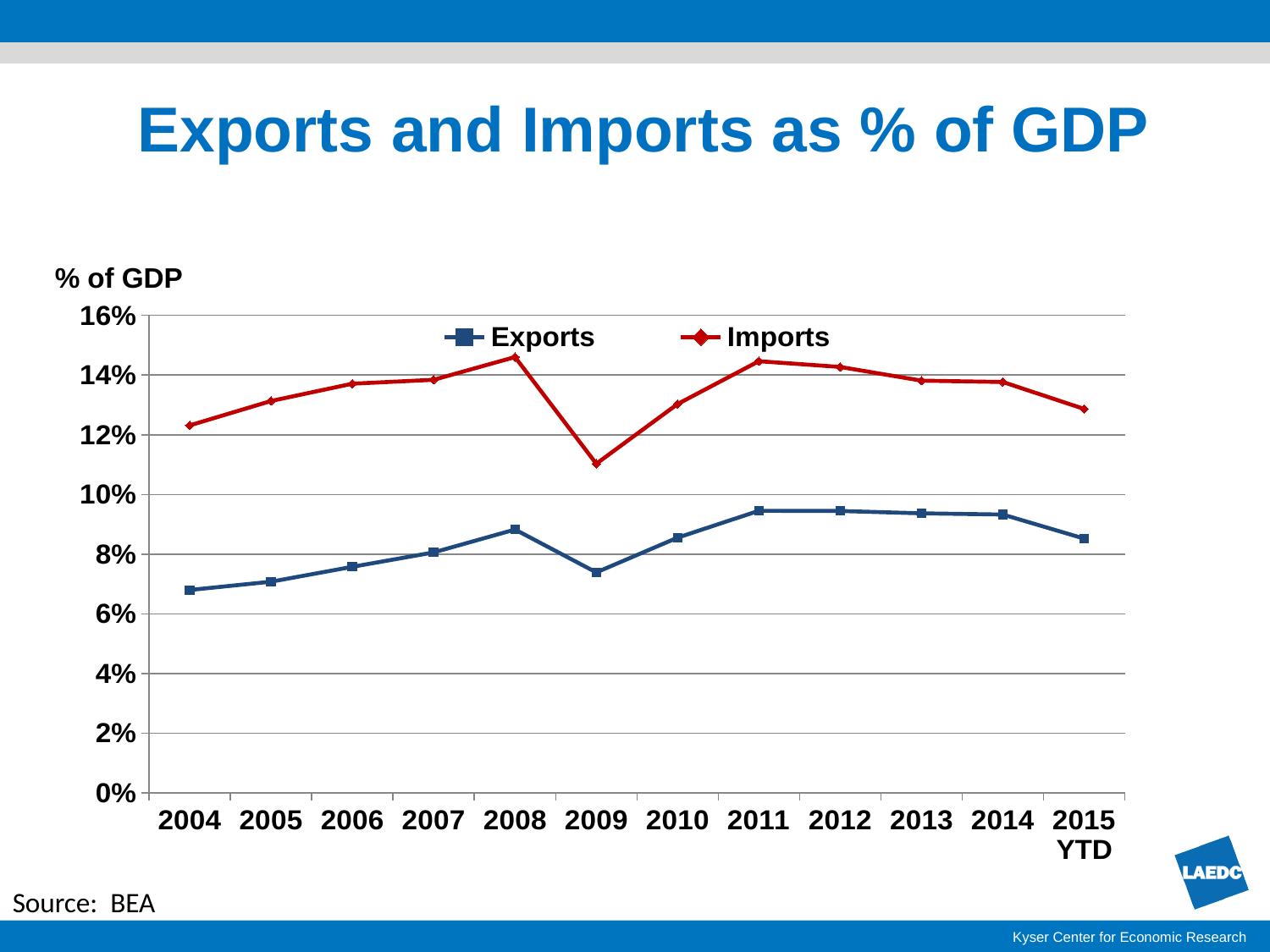
Is the Exports value for 2004 greater or less than 8%? less In which year is the Imports value lowest? 2009 Is the Imports value for 2009 greater or less than 12%? less What kind of chart is shown on the slide? line chart How many series does the legend list? 2 In which year is the Exports value lowest? 2004 In 2010, which is larger, Exports or Imports? Imports What is the label on the vertical axis of the chart? % of GDP Is the Exports value for 2011 greater or less than 8%? greater Do Exports rise or fall from 2004 to 2008? rise How many years are plotted along the x axis? 12